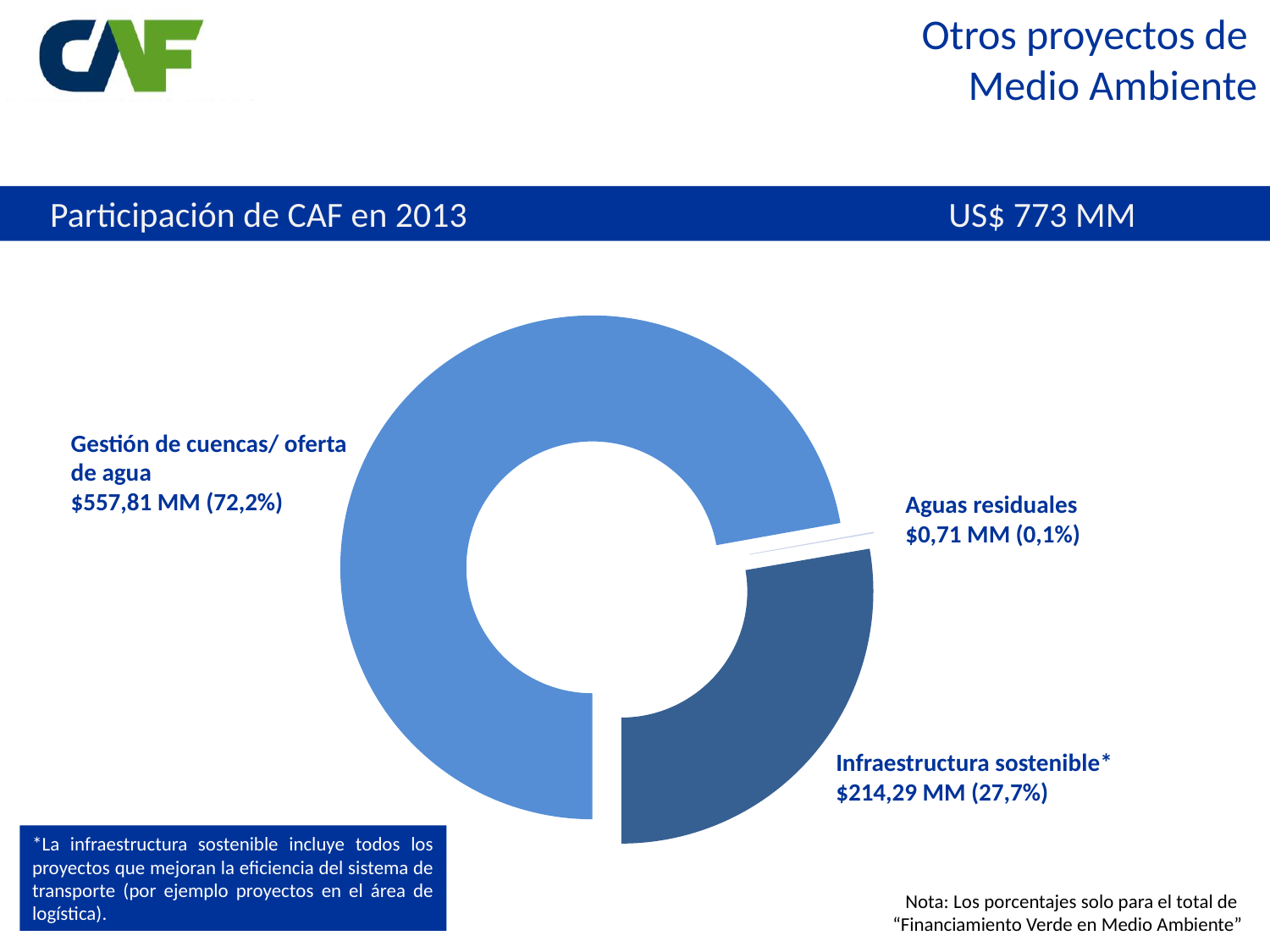
What share of the chart does Gestión de cuencas/ oferta de agua represent? 72,2% What total amount is shown in the header bar for CAF's participation in 2013? US$ 773 MM What is the difference in value between Gestión de cuencas/ oferta de agua and Infraestructura sostenible? $343,52 MM Which is larger, the value for Infraestructura sostenible or the value for Aguas residuales? Infraestructura sostenible How many categories does the chart show? 3 What is the value for Infraestructura sostenible? $214,29 MM What is the value for Gestión de cuencas/ oferta de agua? $557,81 MM What share of the chart does Infraestructura sostenible represent? 27,7% What kind of chart is shown on the slide? Pie chart (doughnut) Which category has the largest share of the chart? Gestión de cuencas/ oferta de agua Which category has the smallest share of the chart? Aguas residuales What is the value for Aguas residuales? $0,71 MM